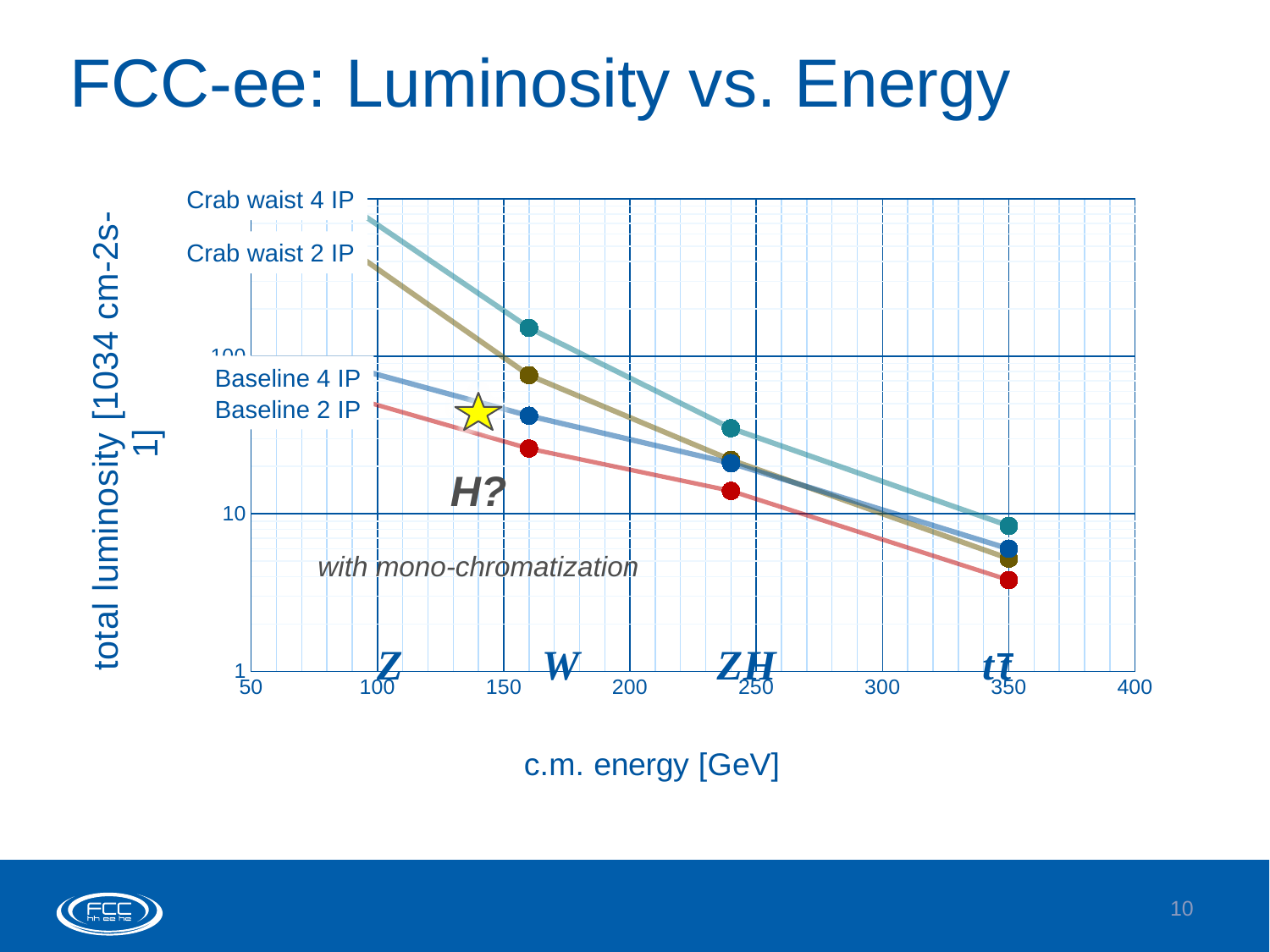
Is the Baseline 2 IP luminosity at 240 GeV greater or less than 10? greater Is the Baseline 2 IP luminosity at 350 GeV greater or less than 10? less At 240 GeV, which is larger: the Crab waist 4 IP luminosity or the Baseline 2 IP luminosity? Crab waist 4 IP Does the total luminosity rise or fall as the c.m. energy increases? Falls What kind of chart is shown on the slide? Line chart Is the Crab waist 4 IP luminosity at 160 GeV greater or less than 100? greater Which series has the highest luminosity at 160 GeV? Crab waist 4 IP How many marked data points does each series have on the chart? 3 Which series has the lowest luminosity at 350 GeV? Baseline 2 IP How many series (curves) are labelled on the chart? 4 What is the label of the x axis? c.m. energy [GeV]